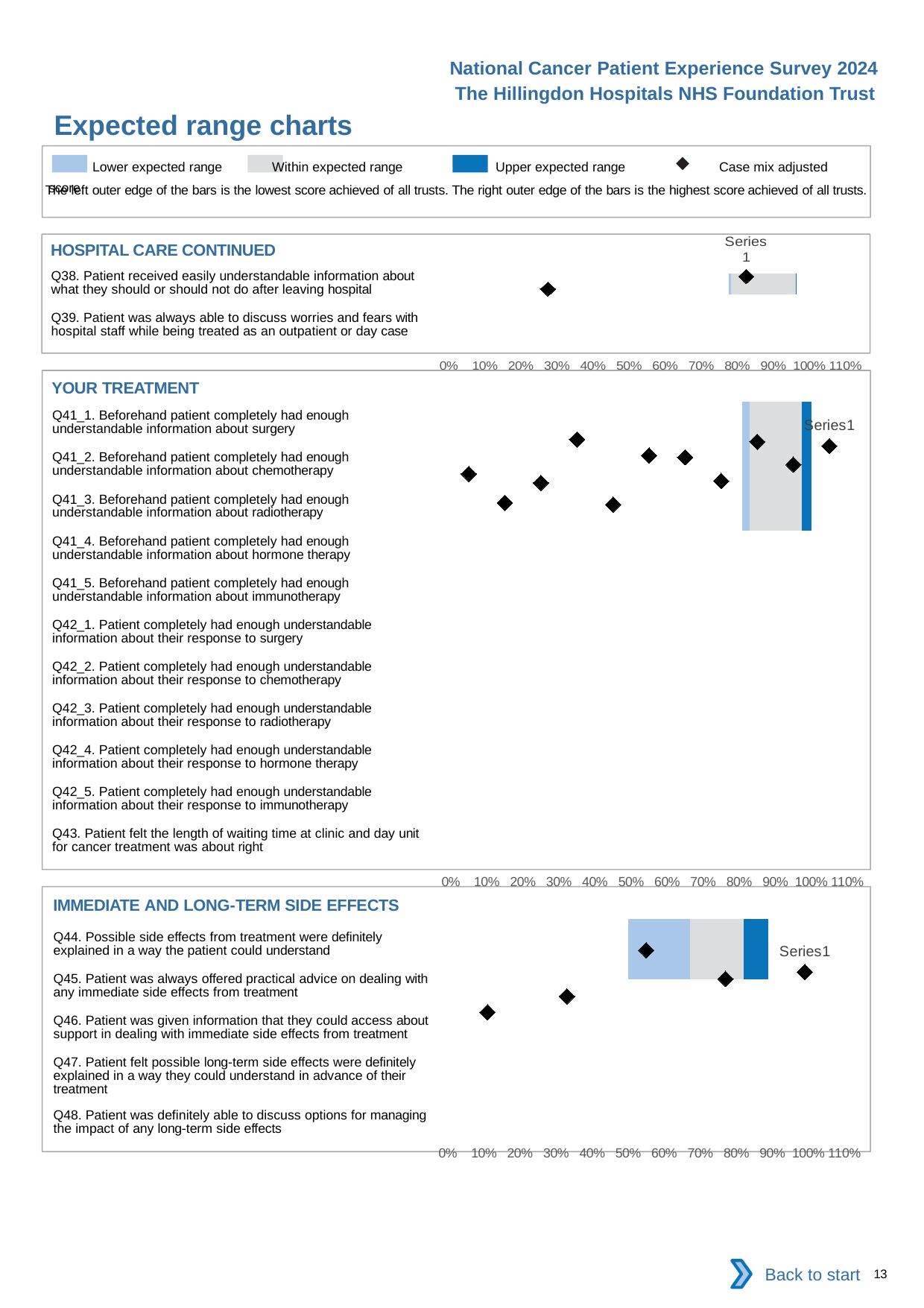
How many survey questions are listed in the 'HOSPITAL CARE CONTINUED' chart? 2 How many entries does the legend at the top of the slide list? 4 In the legend at the top of the slide, what symbol represents the case mix adjusted score? A black diamond How many survey questions are listed in the 'IMMEDIATE AND LONG-TERM SIDE EFFECTS' chart? 5 What is the highest tick label shown on the x axis of the 'YOUR TREATMENT' chart? 110% How many survey questions are listed in the 'YOUR TREATMENT' chart? 11 What is the lowest tick label shown on the x axis of the 'IMMEDIATE AND LONG-TERM SIDE EFFECTS' chart? 0%